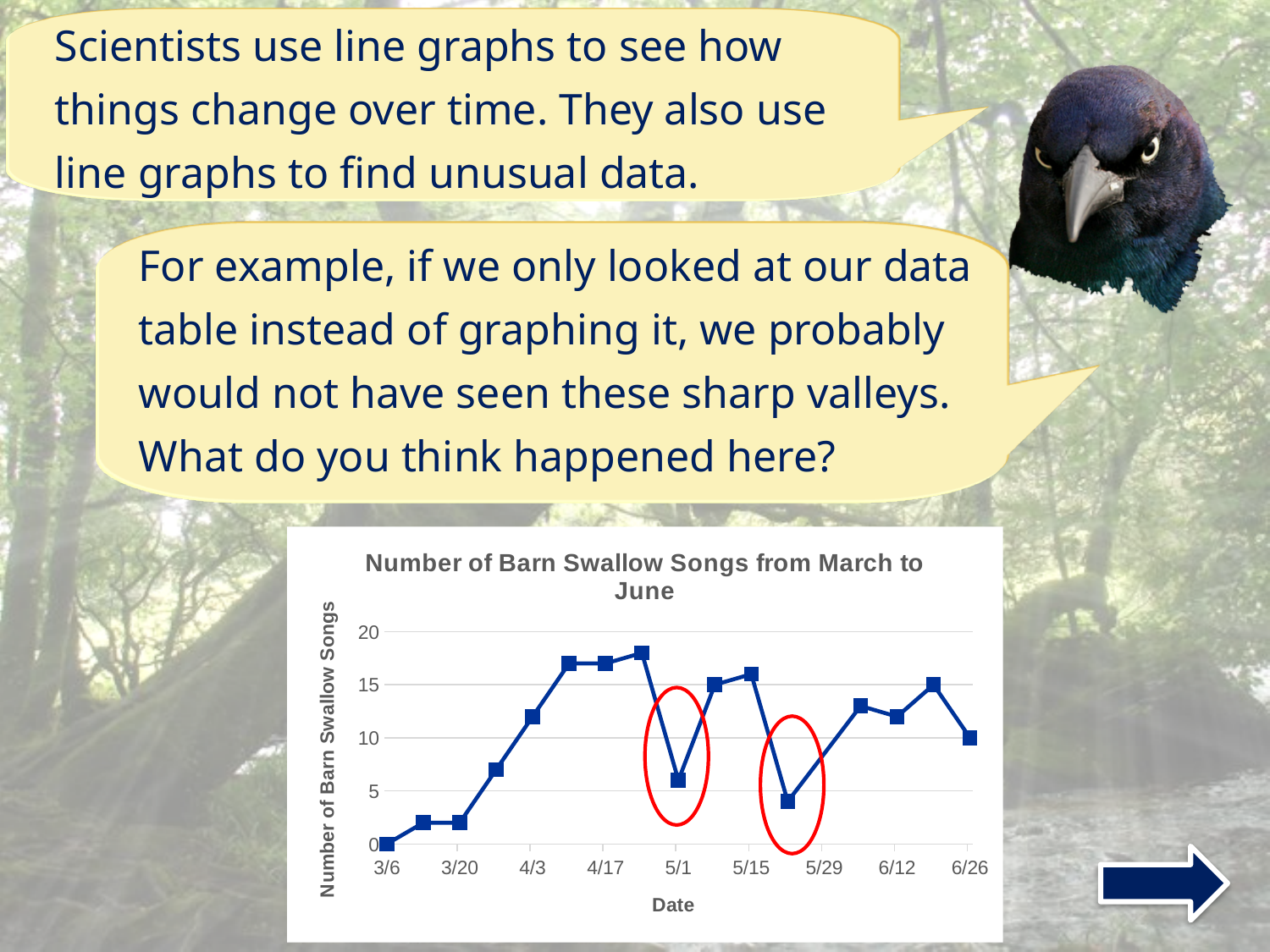
Which date has the larger number of songs, 5/1 or 5/15? 5/15 Do the values rise or fall from 3/6 to 4/3? rise What is the number of barn swallow songs on 6/26? 10 What kind of chart is shown on the slide? line chart What is the label of the y axis of the chart? Number of Barn Swallow Songs What is the number of barn swallow songs on 3/6? 0 Is the value for 5/1 greater or less than 10? less How many data points are plotted on the line? 16 Is the value for 4/3 greater or less than 10? greater On which date is the number of barn swallow songs lowest? 3/6 Is the value for 4/17 greater or less than 15? greater What is the title of the chart? Number of Barn Swallow Songs from March to June